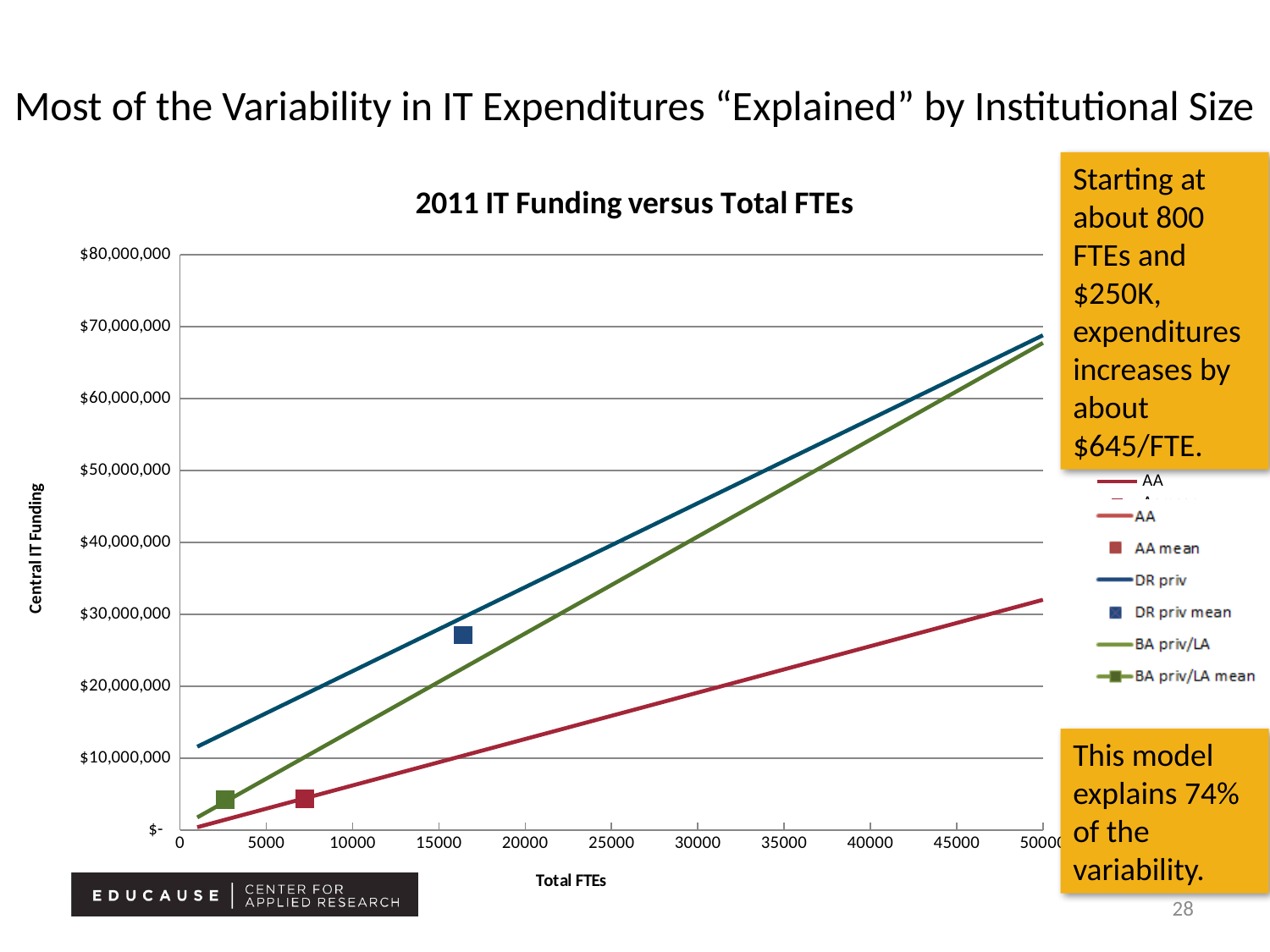
Is the Central IT Funding value of the DR priv mean marker greater or less than $30,000,000? less Which mean marker is at a higher Total FTEs value: the DR priv mean or the AA mean? DR priv mean What kind of chart is shown on the slide? line chart At 30000 Total FTEs, which line is higher: DR priv or AA? DR priv Is the Central IT Funding value of the BA priv/LA mean marker greater or less than $10,000,000? less Which line has the highest Central IT Funding at 0 Total FTEs? DR priv What is the title of the chart? 2011 IT Funding versus Total FTEs Do the plotted lines rise or fall as Total FTEs increase? rise Is the Central IT Funding value of the DR priv mean marker greater or less than $20,000,000? greater According to the slide, what percentage of the variability does the model explain? 74% Which line has the lowest Central IT Funding at 50000 Total FTEs? AA